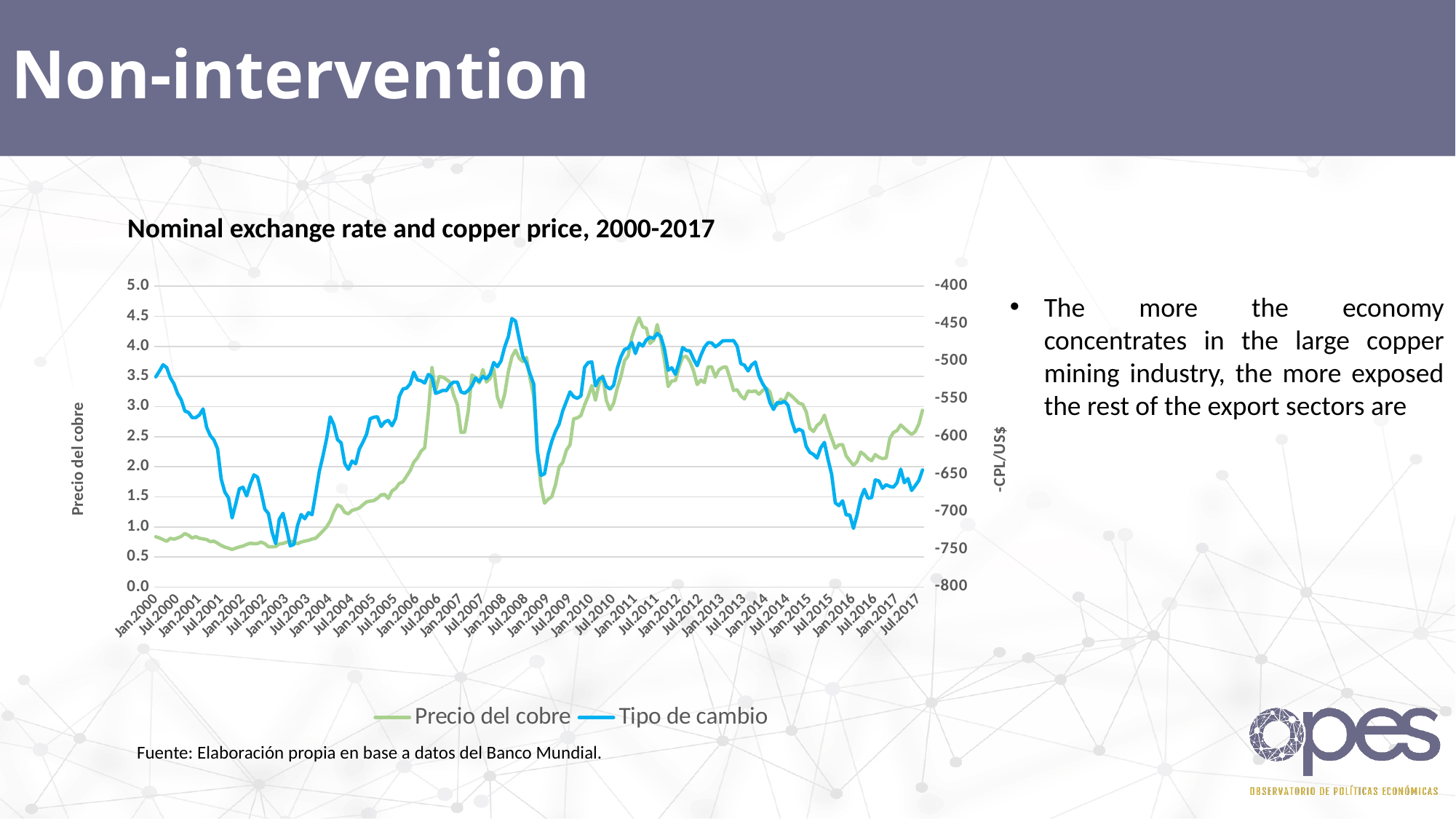
Is the value of Precio del cobre at Jul.2017 greater or less than 2.5? greater How many series does the chart's legend list? 2 Does the Precio del cobre line rise or fall between Jan.2011 and Jan.2016? fall Is the value of Precio del cobre at Jan.2003 greater or less than 1.0? less What is the title of the chart? Nominal exchange rate and copper price, 2000-2017 Is the peak value of Precio del cobre around Jan.2011 greater or less than 4.0? greater What kind of chart is shown on the slide? Line chart What are the two series named in the chart's legend? Precio del cobre and Tipo de cambio Does the Precio del cobre line rise or fall between Jul.2008 and Jan.2009? fall Does the Precio del cobre line rise or fall between Jan.2003 and Jan.2008? rise